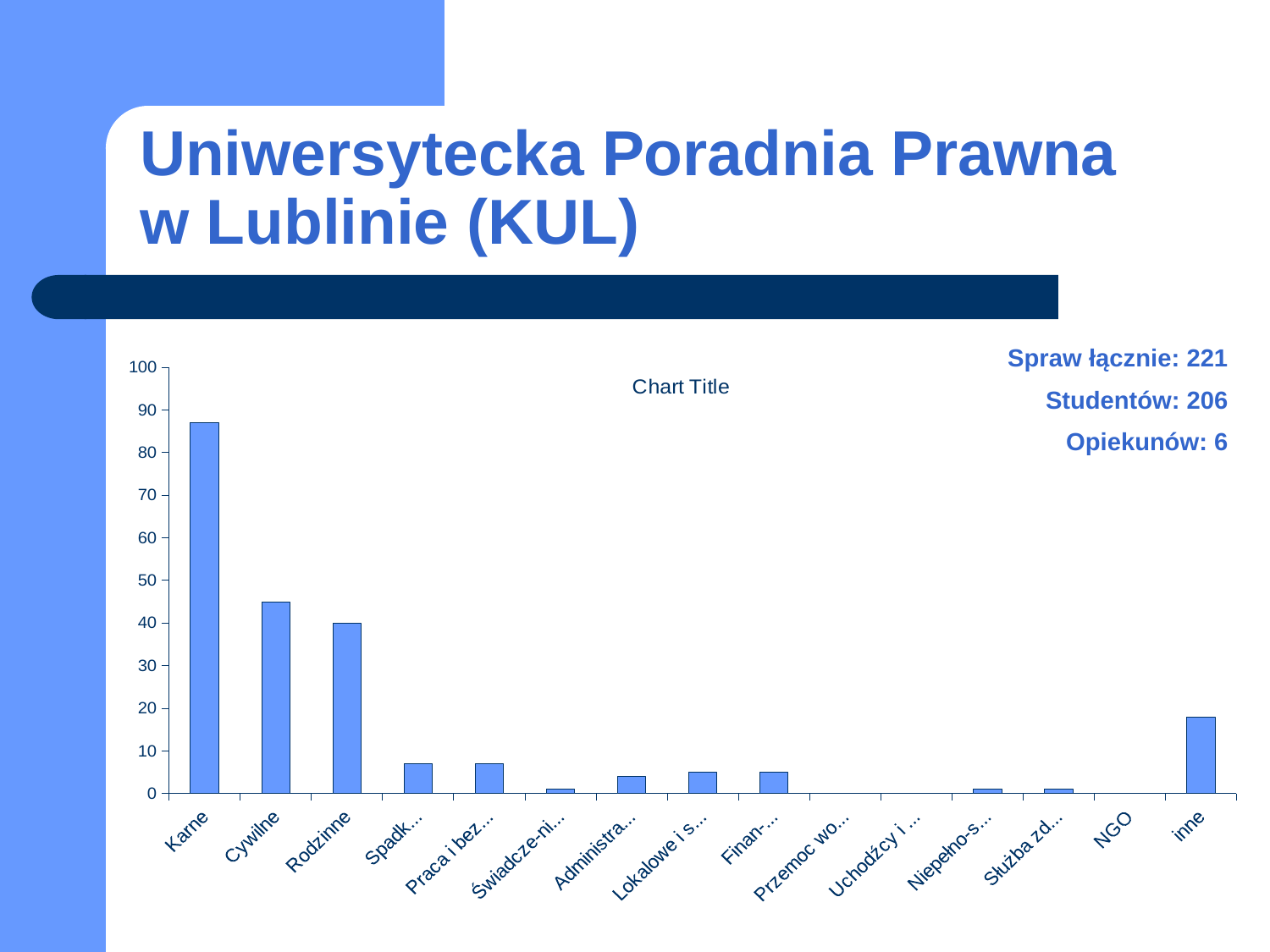
Which is larger, the value for Cywilne or the value for Rodzinne? Cywilne What kind of chart is shown on the slide? bar chart Is the value for Rodzinne greater or less than 50? less How many categories are shown on the x axis? 15 Which is larger, the value for inne or the value for NGO? inne Is the value for Cywilne greater or less than 40? greater Which category has the highest bar? Karne Which is larger, the value for Karne or the value for Cywilne? Karne Is the value for Spadk... greater or less than 10? less What is the title shown on the chart? Chart Title